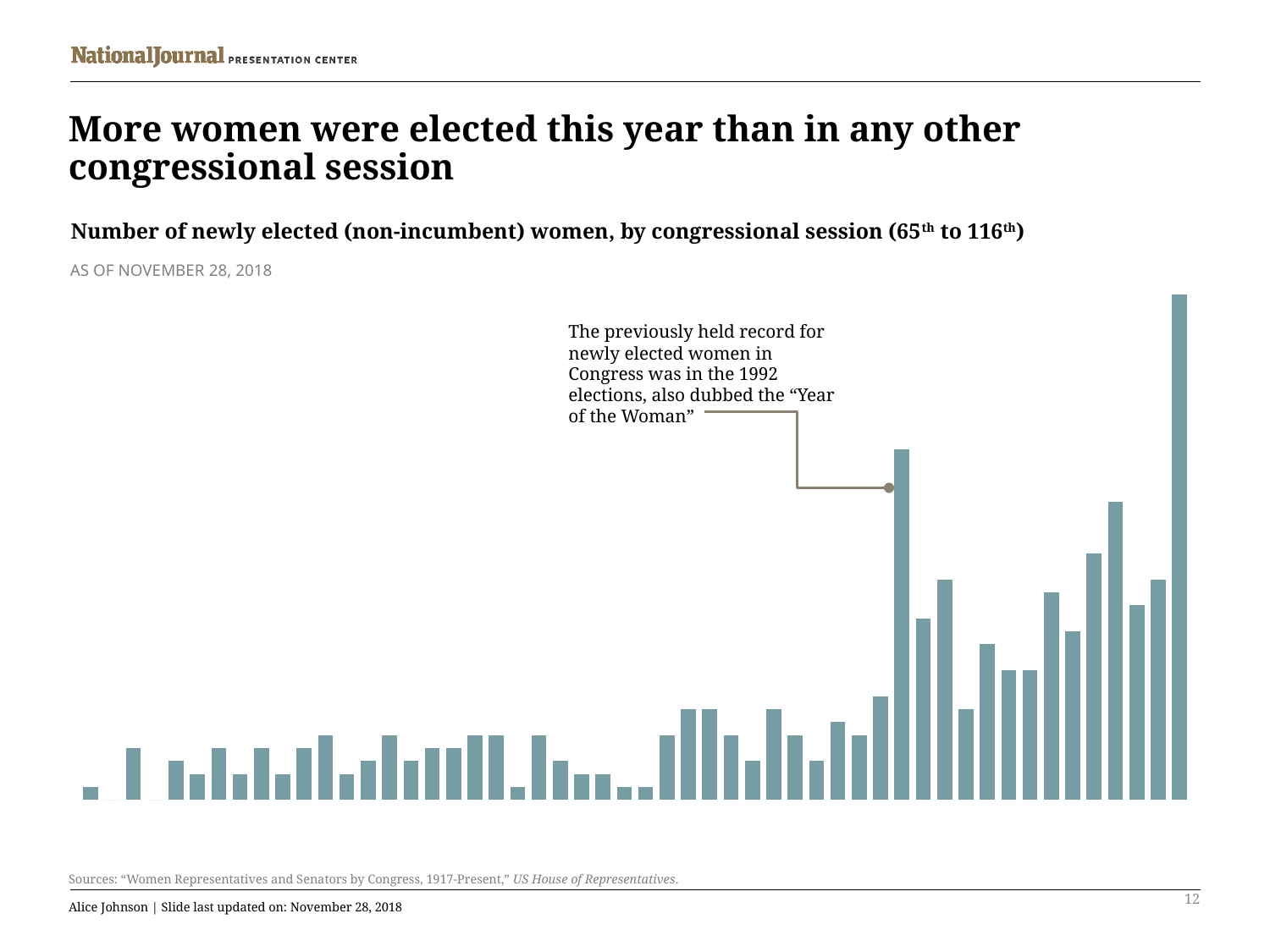
How many congressional sessions does the chart cover, according to its title? 52 Do the values in the chart generally rise or fall from left to right across the congressional sessions? rise Which is larger: the bar for the 116th congressional session (rightmost bar) or the bar for the 1992 elections marked by the annotation? 116th congressional session According to the annotation, in which election year was the previous record for newly elected women in Congress set? 1992 Which congressional session has the highest number of newly elected women in the chart? 116th Is the bar for the 1992 elections the highest or the second highest bar in the chart? second highest What nickname does the annotation give to the 1992 elections? Year of the Woman What kind of chart is shown on the slide? bar chart Which congressional sessions does the chart span, according to its title? 65th to 116th